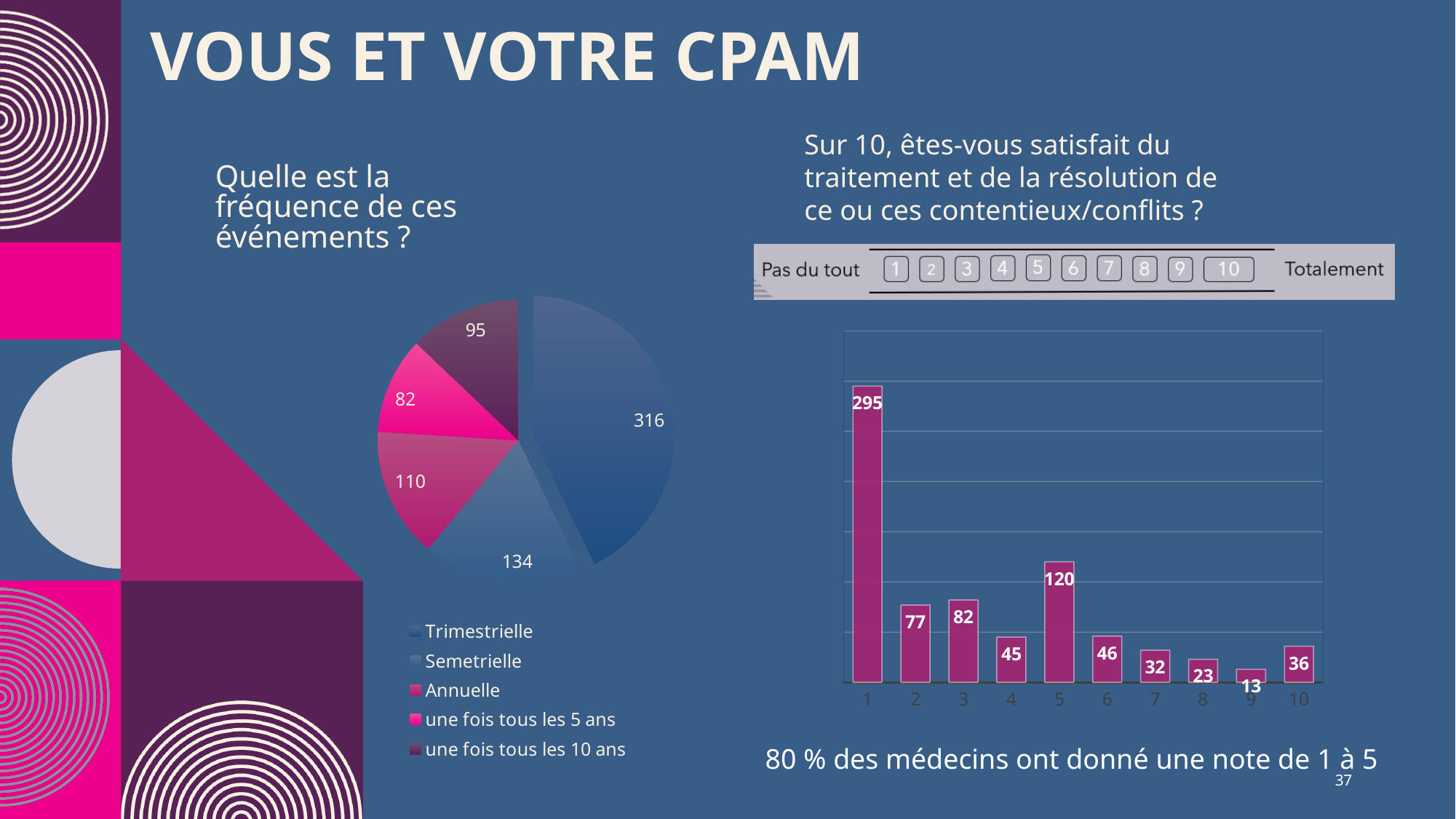
In the bar chart on the right, what is the value for rating 5? 120 In the pie chart on the left, which category has the smallest slice? une fois tous les 5 ans In the bar chart on the right, which rating has the highest value? 1 In the bar chart on the right, which rating has the lowest value? 9 In the pie chart on the left, what is the value for Trimestrielle? 316 What type of chart is shown on the right of the slide? bar chart In the pie chart on the left, which category has the largest slice? Trimestrielle In the pie chart on the left, what is the value for Annuelle? 110 How many categories does the legend of the pie chart on the left list? 5 In the bar chart on the right, which is larger: the value for rating 2 or rating 3? rating 3 In the pie chart on the left, what is the difference between the Semetrielle and Annuelle values? 24 In the bar chart on the right, what is the difference between the values for rating 1 and rating 5? 175